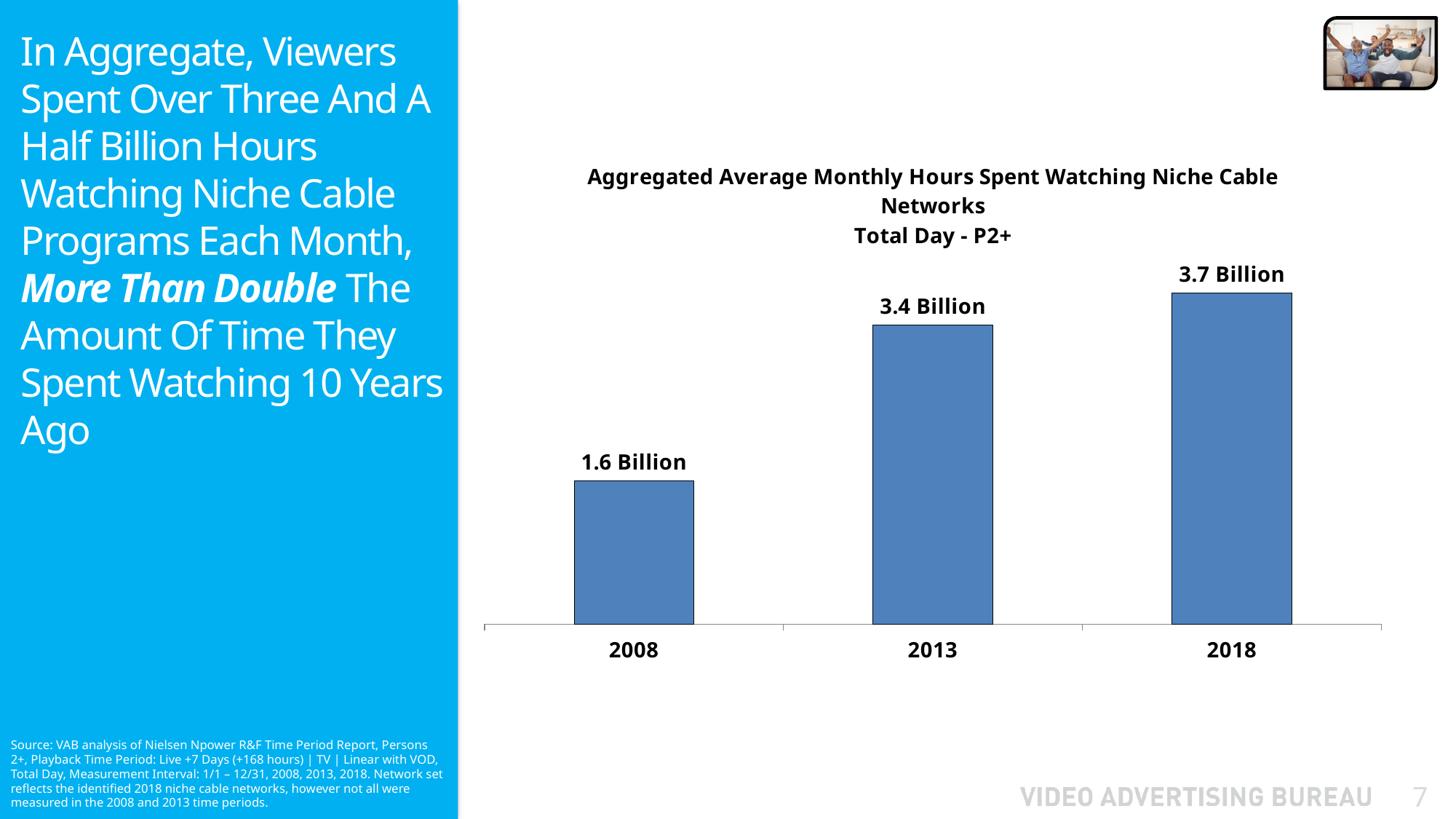
What is the difference between the 2013 and 2008 values? 1.8 Billion Which year has the lowest value? 2008 What is the difference between the 2018 and 2008 values? 2.1 Billion How many years are shown on the chart? 3 What is the value for 2013? 3.4 Billion What is the value for 2008? 1.6 Billion Do the values rise or fall from 2008 to 2018? Rise What is the value for 2018? 3.7 Billion What is the title of the chart? Aggregated Average Monthly Hours Spent Watching Niche Cable Networks Total Day - P2+ What kind of chart is shown? Bar chart Which is larger, the value for 2013 or the value for 2008? 2013 Which year has the highest value? 2018